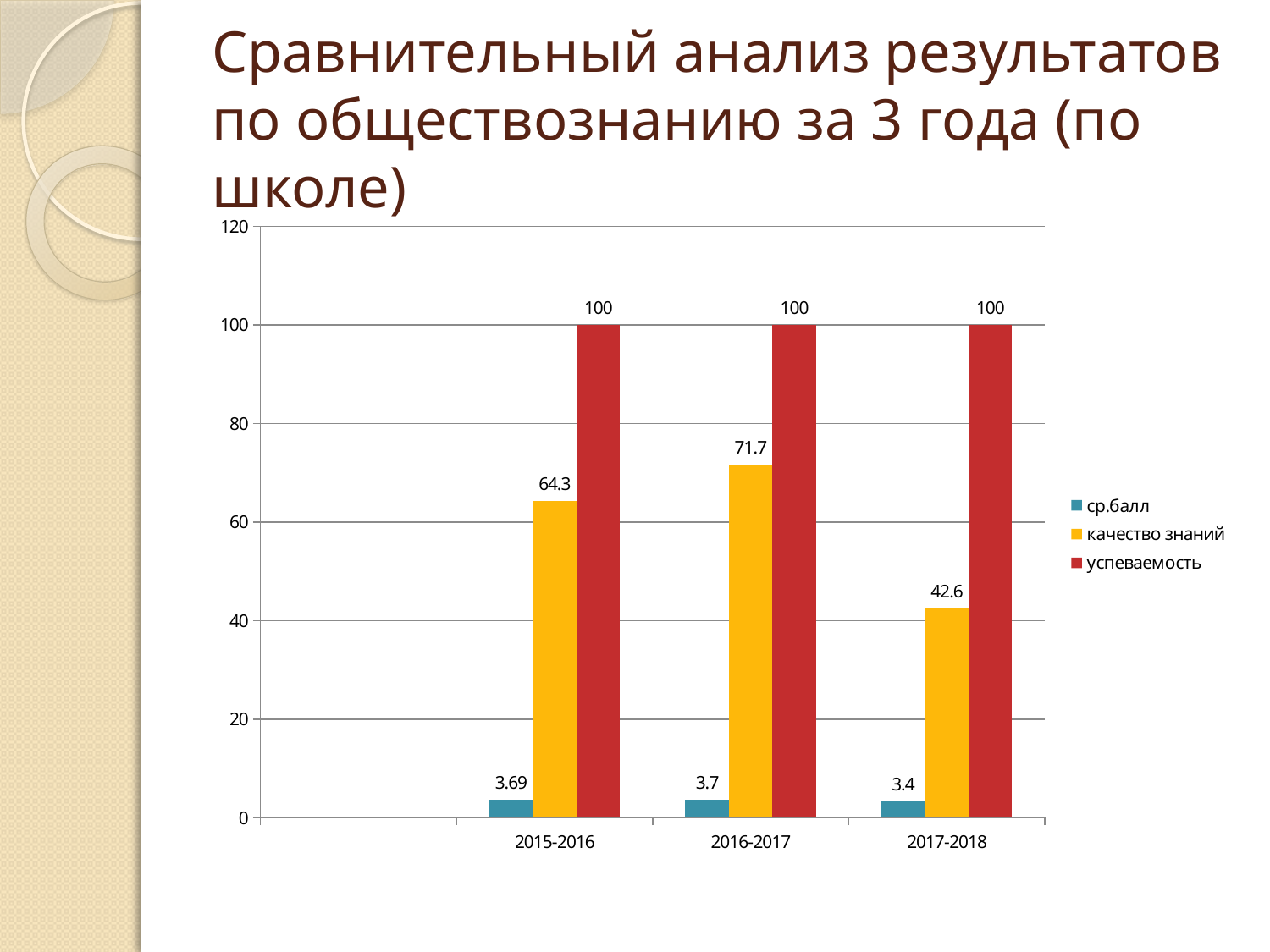
Is the value of качество знаний for 2017-2018 greater or less than 60? less How many series does the legend list? 3 Which is larger: качество знаний in 2015-2016 or in 2017-2018? 2015-2016 What kind of chart is shown on the slide? bar chart What is the value of успеваемость for 2017-2018? 100 What is the difference between качество знаний in 2016-2017 and 2017-2018? 29.1 What is the value of качество знаний for 2016-2017? 71.7 How many year categories are shown on the x axis? 3 What is the value of ср.балл for 2015-2016? 3.69 Which year has the lowest value for ср.балл? 2017-2018 Which year has the highest value for качество знаний? 2016-2017 Which colour represents успеваемость in the legend? red